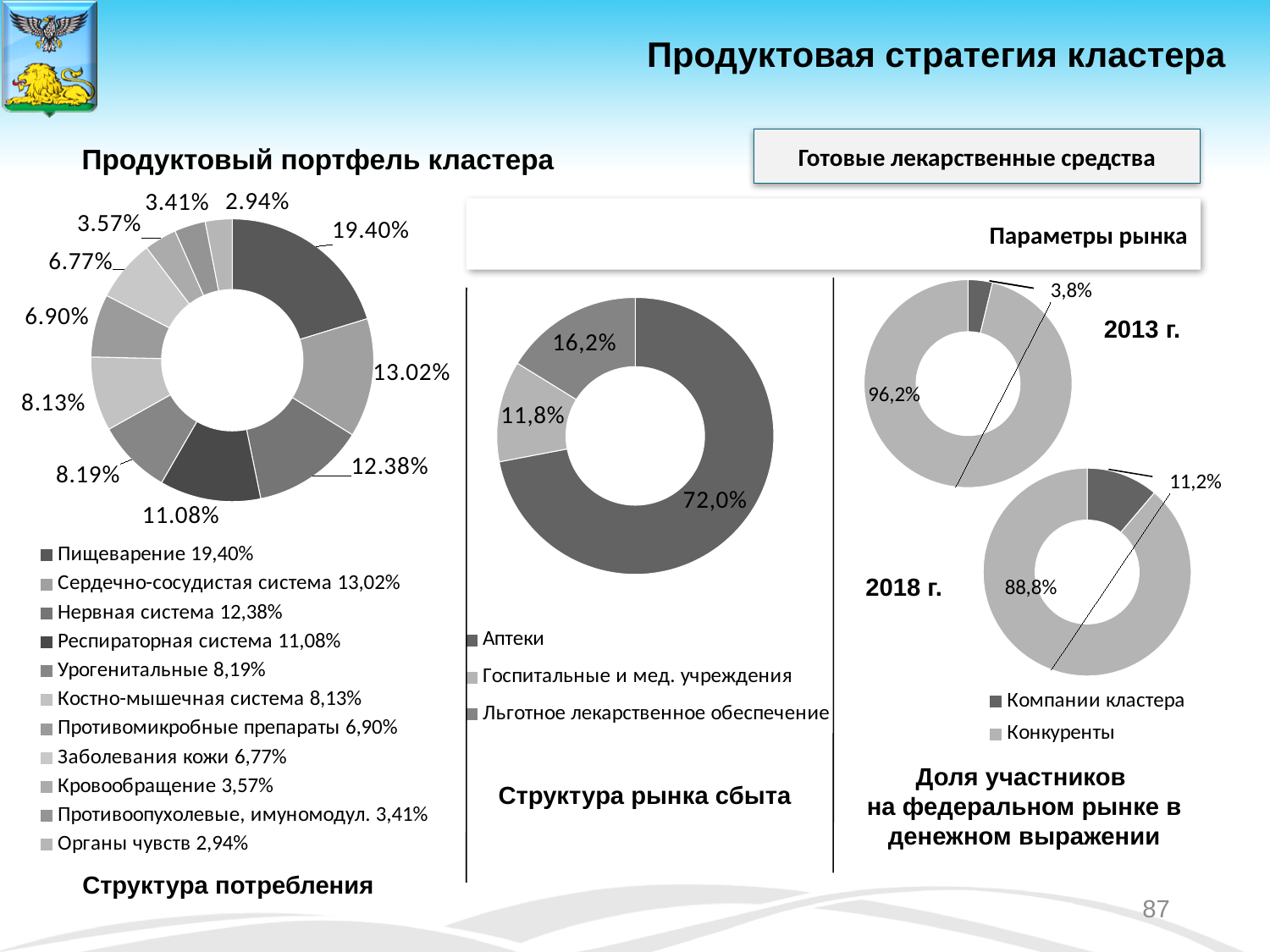
In the 'Продуктовый портфель кластера' chart, which category has the largest share? Пищеварение In the 'Продуктовый портфель кластера' chart, which is larger: Урогенитальные or Костно-мышечная система? Урогенитальные What kind of chart is 'Структура рынка сбыта'? Donut (pie) chart In the 'Продуктовый портфель кластера' chart, which category has the smallest share? Органы чувств In the 'Доля участников на федеральном рынке в денежном выражении' chart, what share did Компании кластера have in 2013 г.? 3,8% In the 'Доля участников на федеральном рынке в денежном выражении' chart, by how much did the share of Компании кластера change from 2013 г. to 2018 г.? 7,4% In the 'Структура рынка сбыта' chart, what share does Льготное лекарственное обеспечение have? 16,2% In the 'Структура рынка сбыта' chart, what share do Аптеки have? 72,0% In the 'Продуктовый портфель кластера' chart, what share does Пищеварение have? 19,40% In the 'Доля участников на федеральном рынке в денежном выражении' chart, what share did Конкуренты have in 2018 г.? 88,8% In the 'Продуктовый портфель кластера' chart, what is the difference between the shares of Сердечно-сосудистая система and Нервная система? 0,64% How many categories does the legend of the 'Продуктовый портфель кластера' chart list? 11